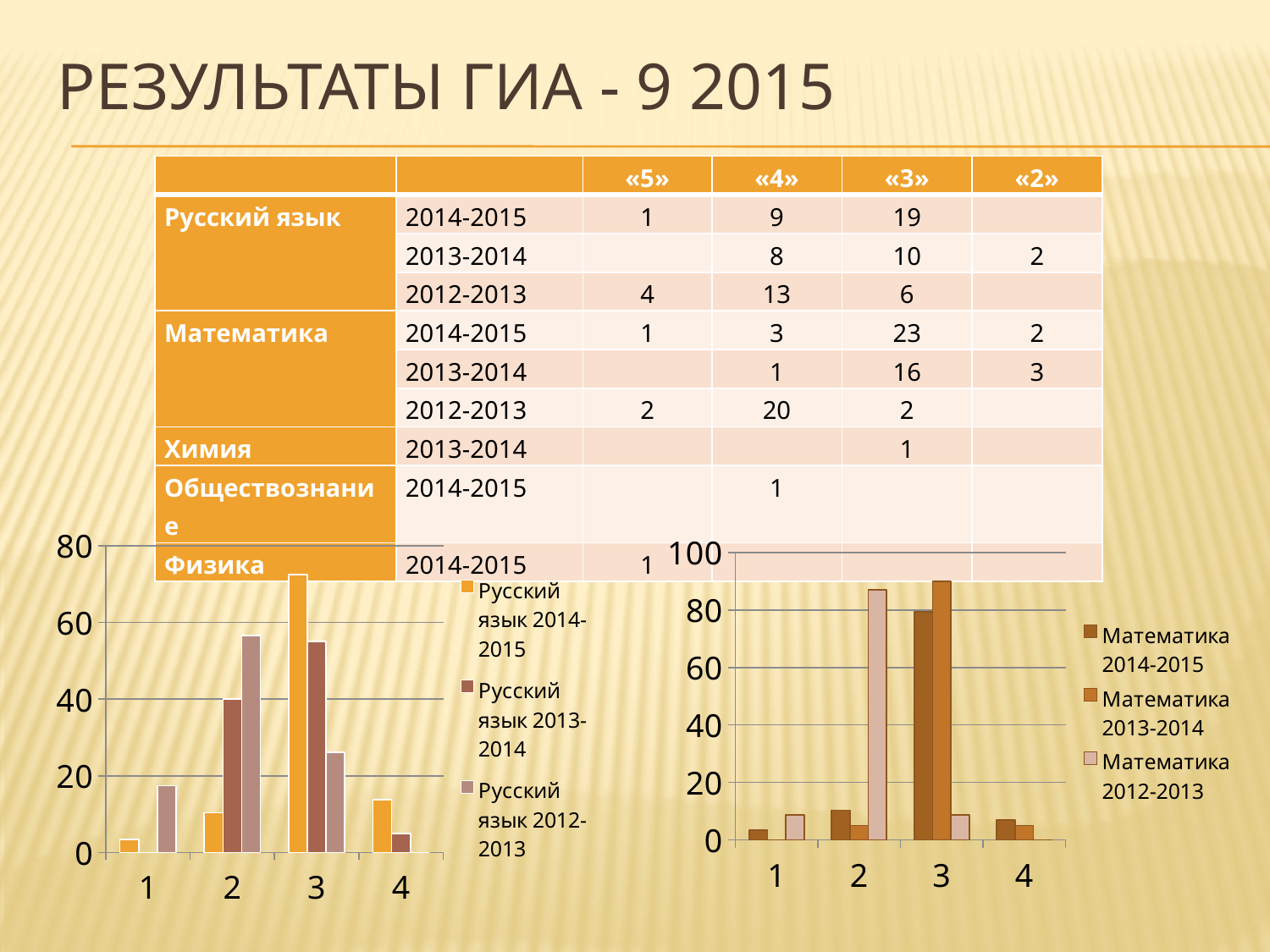
In the right chart, for category 3, which series has the larger value: Математика 2014-2015 or Математика 2013-2014? Математика 2013-2014 How many series does the legend of the left chart list? 3 In the left chart, is the value for category 3 in the series Русский язык 2014-2015 greater or less than 60? greater How many series does the legend of the right chart list? 3 In the left chart, which category has the highest bar for the series Русский язык 2014-2015? 3 How many categories are shown on the x axis of the right chart? 4 What kind of chart is the right chart on the slide? bar chart In the left chart, for category 2, which series has the larger value: Русский язык 2014-2015 or Русский язык 2012-2013? Русский язык 2012-2013 What is the name of the first series listed in the legend of the right chart? Математика 2014-2015 What kind of chart is the left chart on the slide? bar chart In the right chart, which category has the highest bar for the series Математика 2012-2013? 2 In the right chart, is the value for category 2 in the series Математика 2012-2013 greater or less than 80? greater